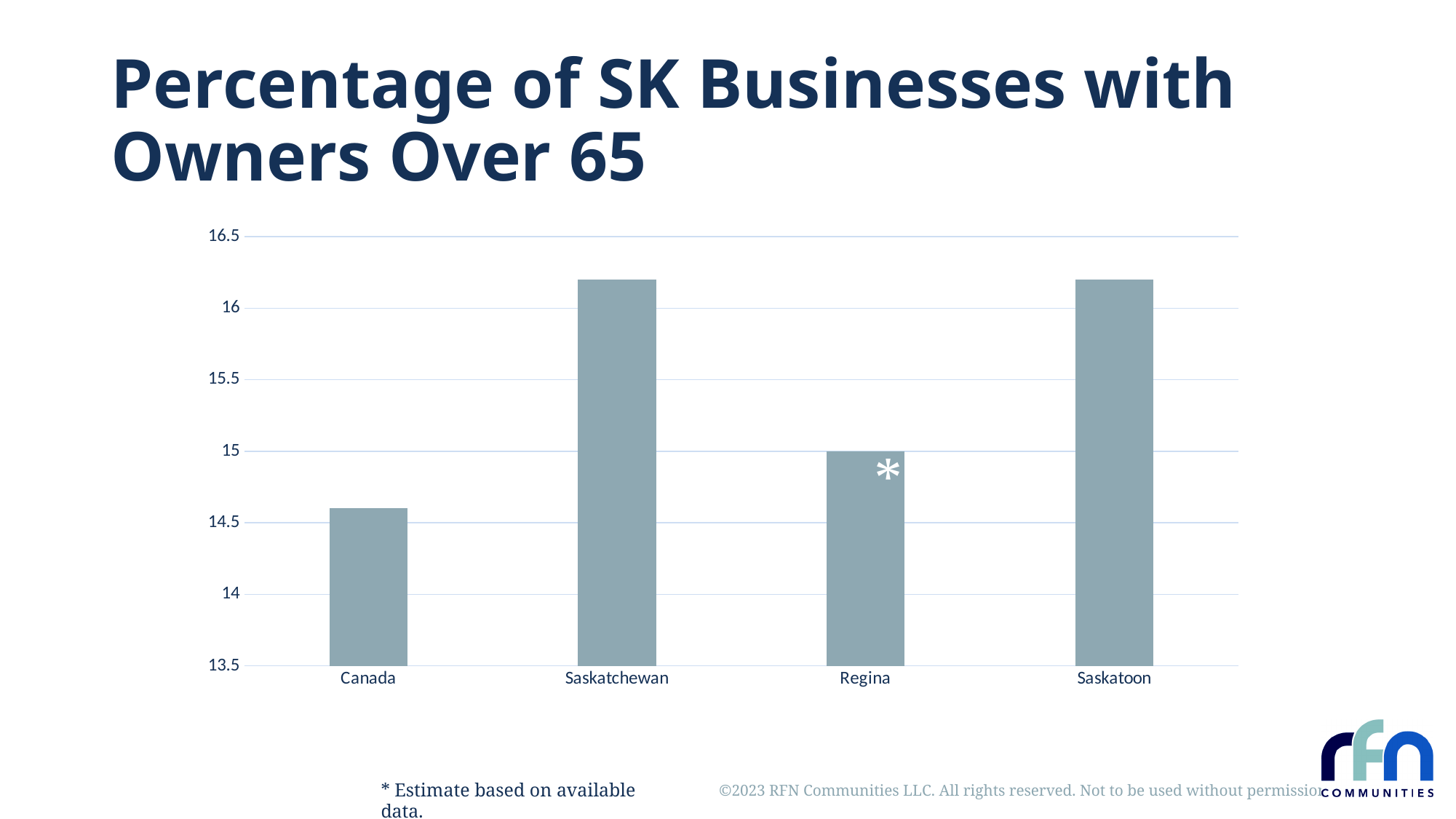
How many categories are shown on the x axis of the chart? 4 Is the value for Saskatoon greater or less than 16? greater Which bar is marked with an asterisk indicating an estimate based on available data? Regina Which category has the lowest value in the chart? Canada Is the value for Saskatchewan greater or less than 16? greater Which has a larger value, Saskatchewan or Canada? Saskatchewan Which has a larger value, Saskatoon or Regina? Saskatoon What is the title of the chart on the slide? Percentage of SK Businesses with Owners Over 65 What type of chart is shown on the slide? bar chart Is the value for Canada greater or less than 15? less What is the value for Regina? 15 Which has a larger value, Canada or Regina? Regina